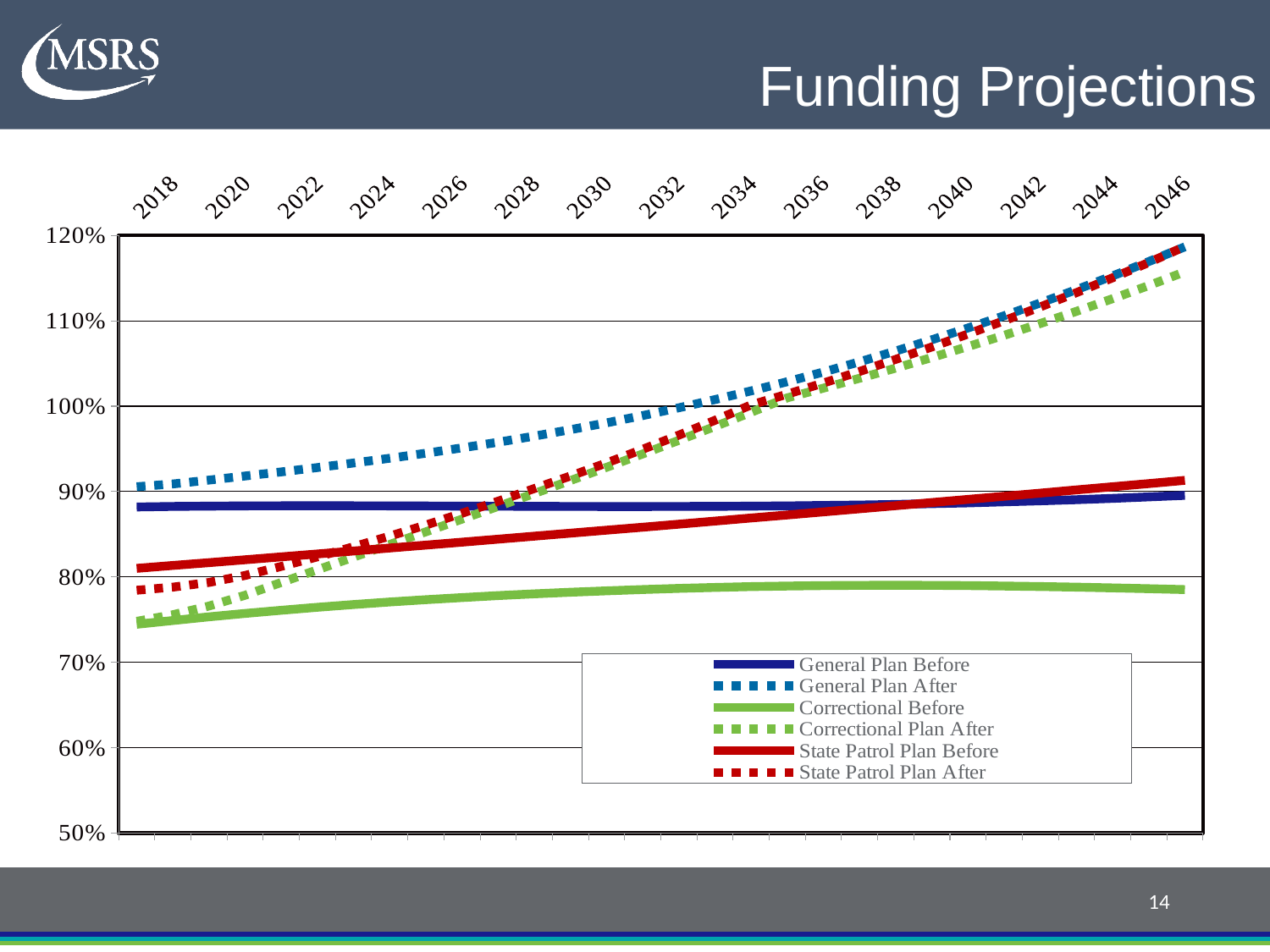
Is the value for General Plan After in 2046 greater or less than 110%? greater Does the General Plan After line rise or fall from 2018 to 2046? Rise How many series does the legend list? 6 Is the value for Correctional Before in 2018 greater or less than 80%? less How many year labels are shown along the x axis? 15 What is the title of the slide containing the chart? Funding Projections In 2046, which is higher: General Plan After or Correctional Plan After? General Plan After Does the State Patrol Plan After line rise or fall from 2018 to 2046? Rise Which legend entry is drawn as a dashed green line? Correctional Plan After What kind of chart is shown on the slide? Line chart Is the value for General Plan Before in 2018 greater or less than 90%? less Which series has the lowest value in 2046? Correctional Before